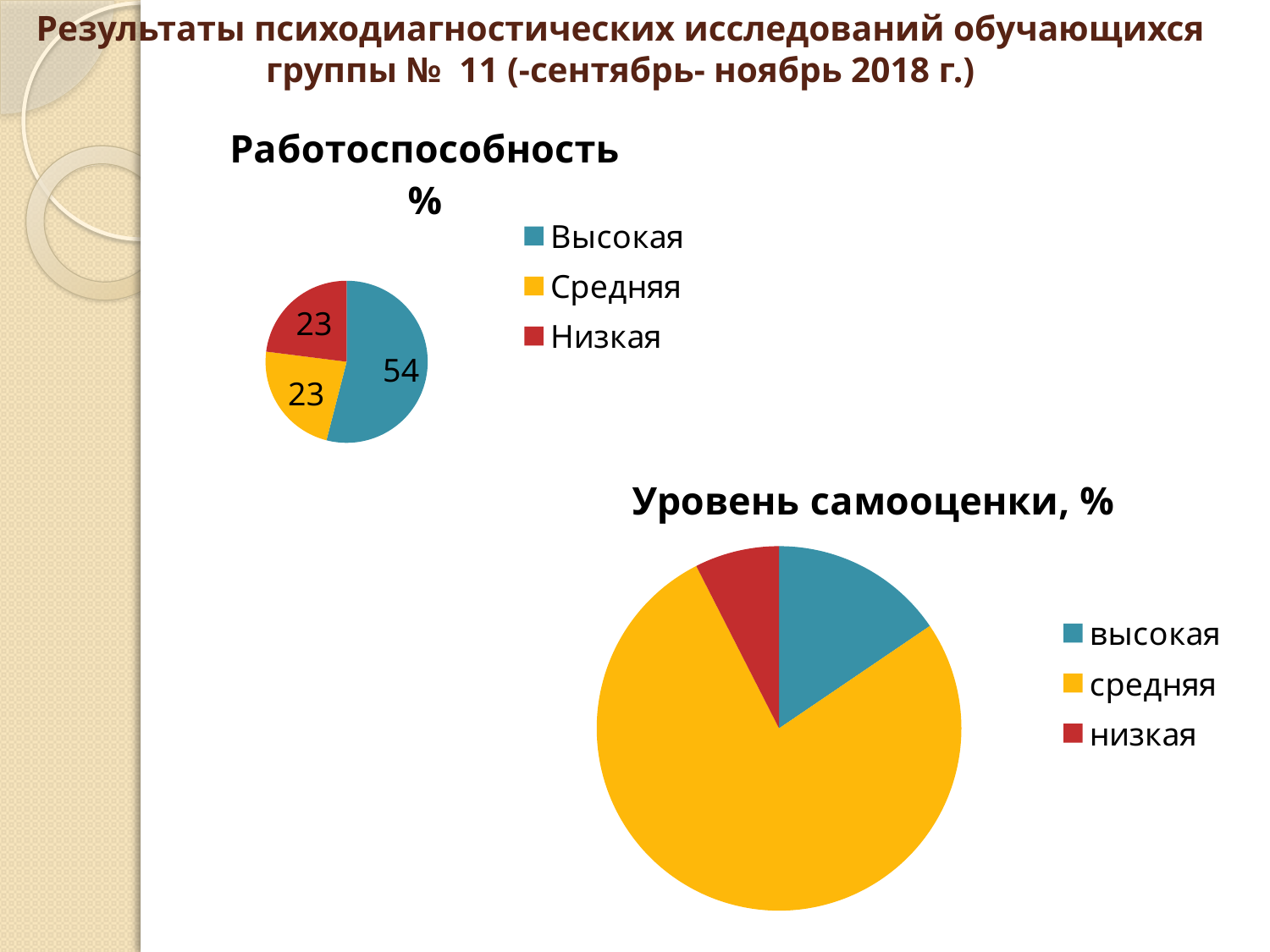
In the 'Уровень самооценки, %' pie chart, which category has the smallest slice? низкая What is the title of the pie chart at the bottom right of the slide? Уровень самооценки, % In the 'Работоспособность %' pie chart, which is larger, the value for Высокая or the value for Низкая? Высокая In the 'Работоспособность %' pie chart, what is the value for Высокая? 54 In the 'Работоспособность %' pie chart, what is the value for Низкая? 23 How many slices does the 'Работоспособность %' pie chart have? 3 How many categories does the legend of the 'Уровень самооценки, %' pie chart list? 3 In the 'Работоспособность %' pie chart, which category has the largest slice? Высокая In the 'Уровень самооценки, %' pie chart, which slice is larger, высокая or низкая? высокая In the 'Уровень самооценки, %' pie chart, which category has the largest slice? средняя In the 'Работоспособность %' pie chart, what is the difference between the values for Высокая and Средняя? 31 What kind of chart is the 'Работоспособность %' chart? Pie chart